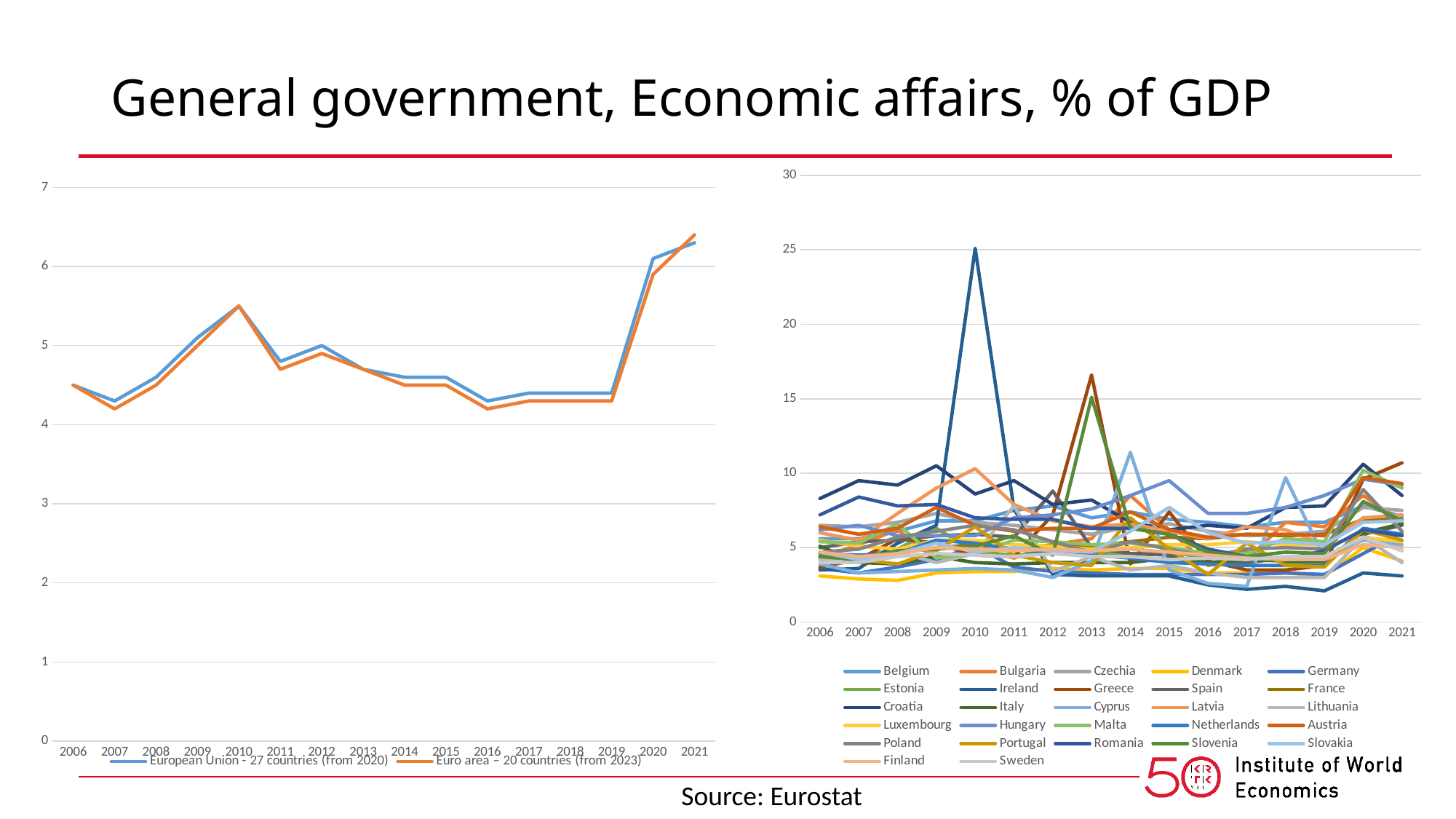
How many series does the legend of the right chart list? 27 In the right chart, which country has the highest value in 2010? Ireland How many years are shown on the x axis of the left chart? 16 In the left chart, do the values rise or fall between 2019 and 2020? rise In the left chart, is the value for the European Union - 27 countries series in 2020 greater or less than 6? greater In the left chart, is the value for the Euro area series in 2016 greater or less than 5? less In the left chart, is the value for the European Union - 27 countries series in 2010 greater or less than 5? greater In the left chart, which year has the highest value for the European Union - 27 countries series? 2021 What kind of chart is the left chart on the slide? line chart In the left chart, which is larger for the European Union - 27 countries series: the value in 2006 or the value in 2021? 2021 How many series does the legend of the left chart list? 2